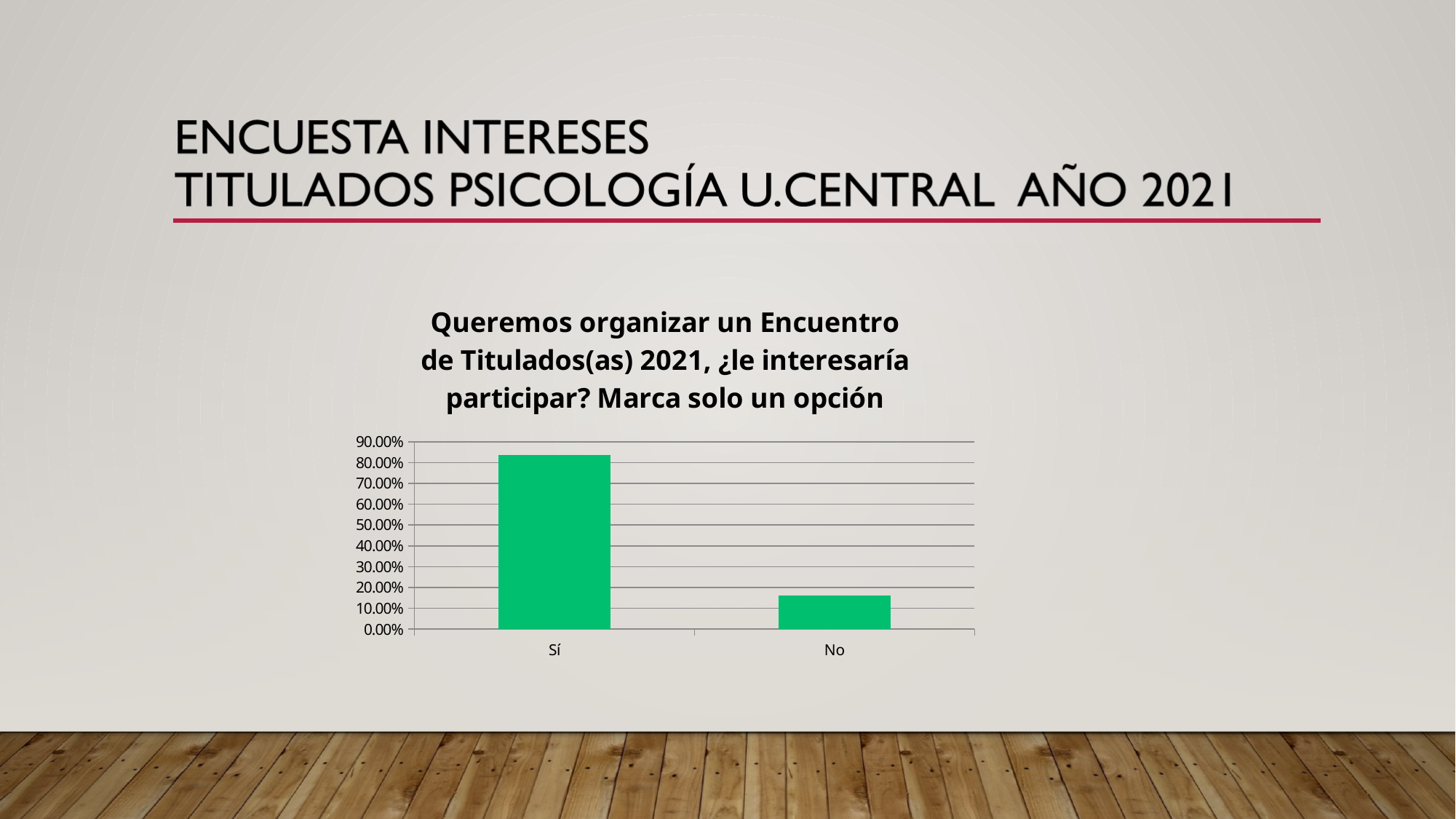
Which category has the lowest value in the chart? No Which is larger, the value for Sí or the value for No? Sí Is the value for No greater or less than 20.00%? less Is the value for Sí greater or less than 80.00%? greater What is the highest value shown on the y axis of the chart? 90.00% How many categories are shown on the x axis of the chart? 2 What kind of chart is shown on the slide? bar chart What colour are the bars in the chart? green Which category has the highest value in the chart? Sí Is the value for No greater or less than 10.00%? greater